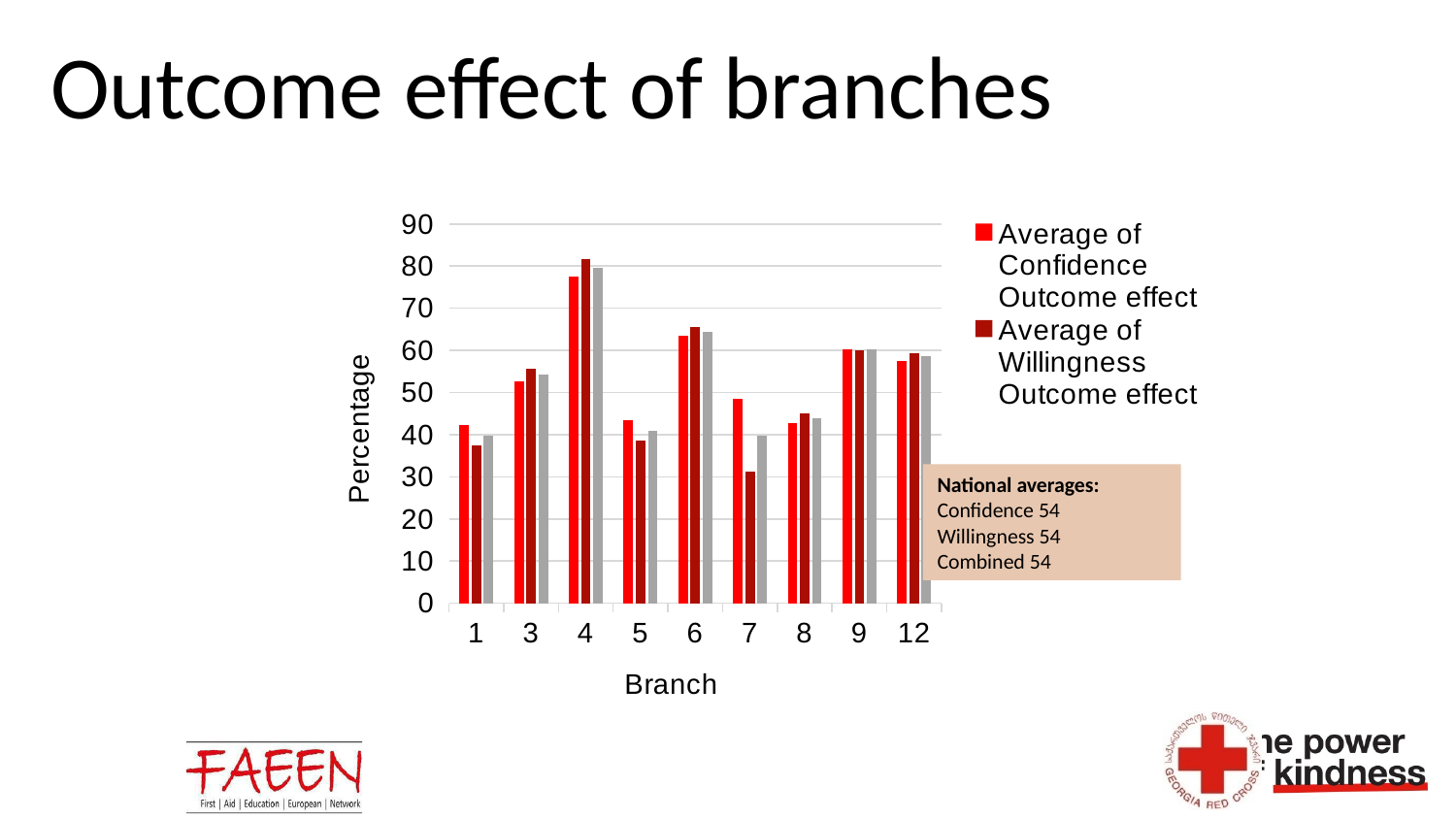
Is the Average of Confidence Outcome effect for branch 4 greater or less than 70? greater Which branch has the highest Average of Confidence Outcome effect? 4 Is the Average of Willingness Outcome effect for branch 6 greater or less than 60? greater What is the label on the chart's vertical axis? Percentage Is the Average of Confidence Outcome effect for branch 8 greater or less than 50? less Which branch has a higher Average of Confidence Outcome effect, branch 4 or branch 7? 4 What kind of chart is shown on the slide? bar chart Which branch has the lowest Average of Willingness Outcome effect? 7 How many series does the chart's legend list? 2 How many branches are shown on the x axis of the chart? 9 For branch 7, which is larger: the Average of Confidence Outcome effect or the Average of Willingness Outcome effect? Average of Confidence Outcome effect